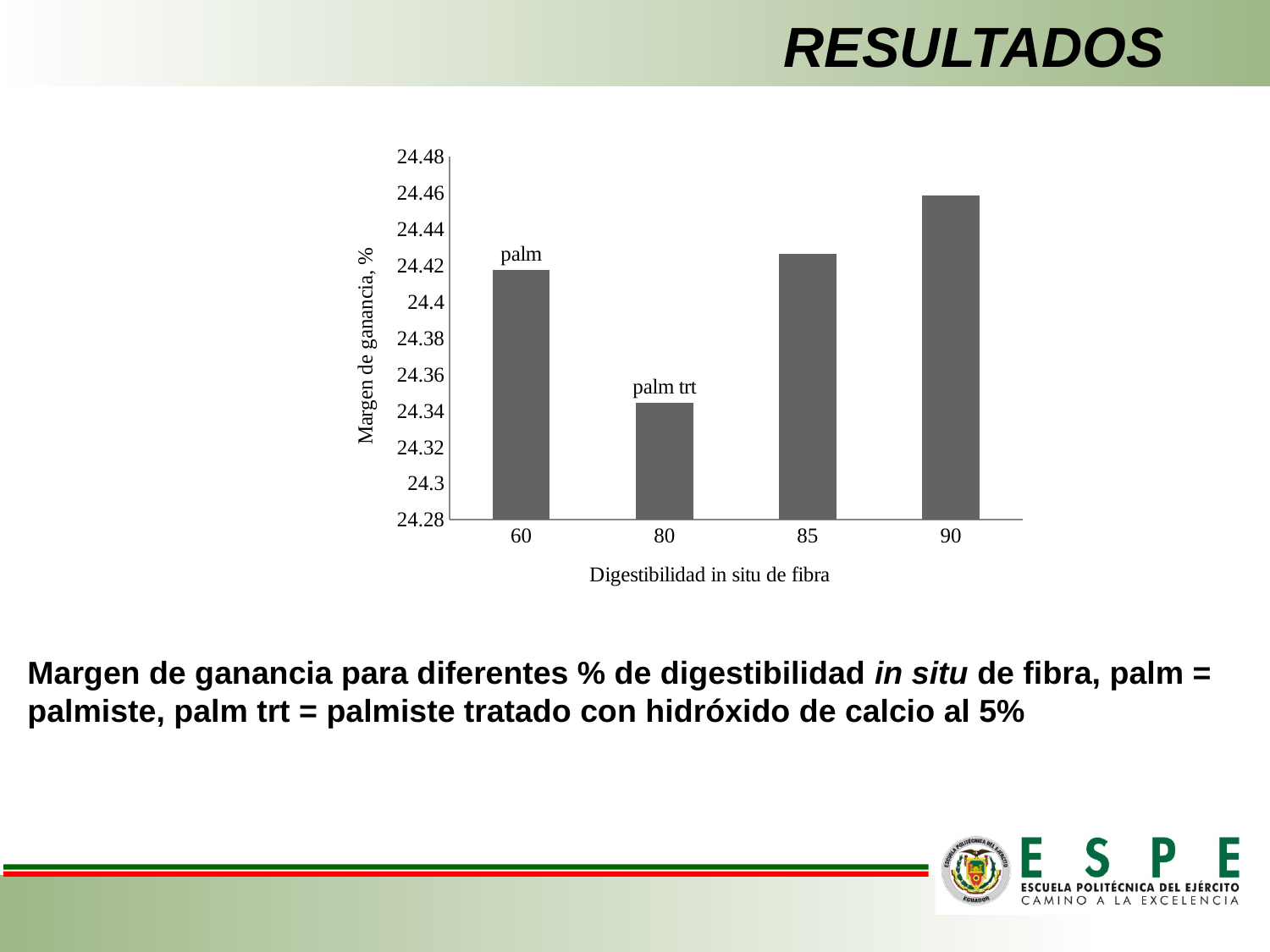
Which has a larger margen de ganancia, the bar for 60 or the bar for 80? 60 Is the value for 90 greater or less than 24.44? greater How many bars (categories) are plotted in the chart? 4 What label is printed above the bar for 80? palm trt Which digestibility category has the highest margen de ganancia? 90 Which digestibility category has the lowest margen de ganancia? 80 Which has a larger margen de ganancia, the bar for 90 or the bar for 85? 90 What is the title of the y-axis of the chart? Margen de ganancia, % Is the value for 80 greater or less than 24.36? less What kind of chart is shown on the slide? bar chart Is the value for 85 greater or less than 24.4? greater